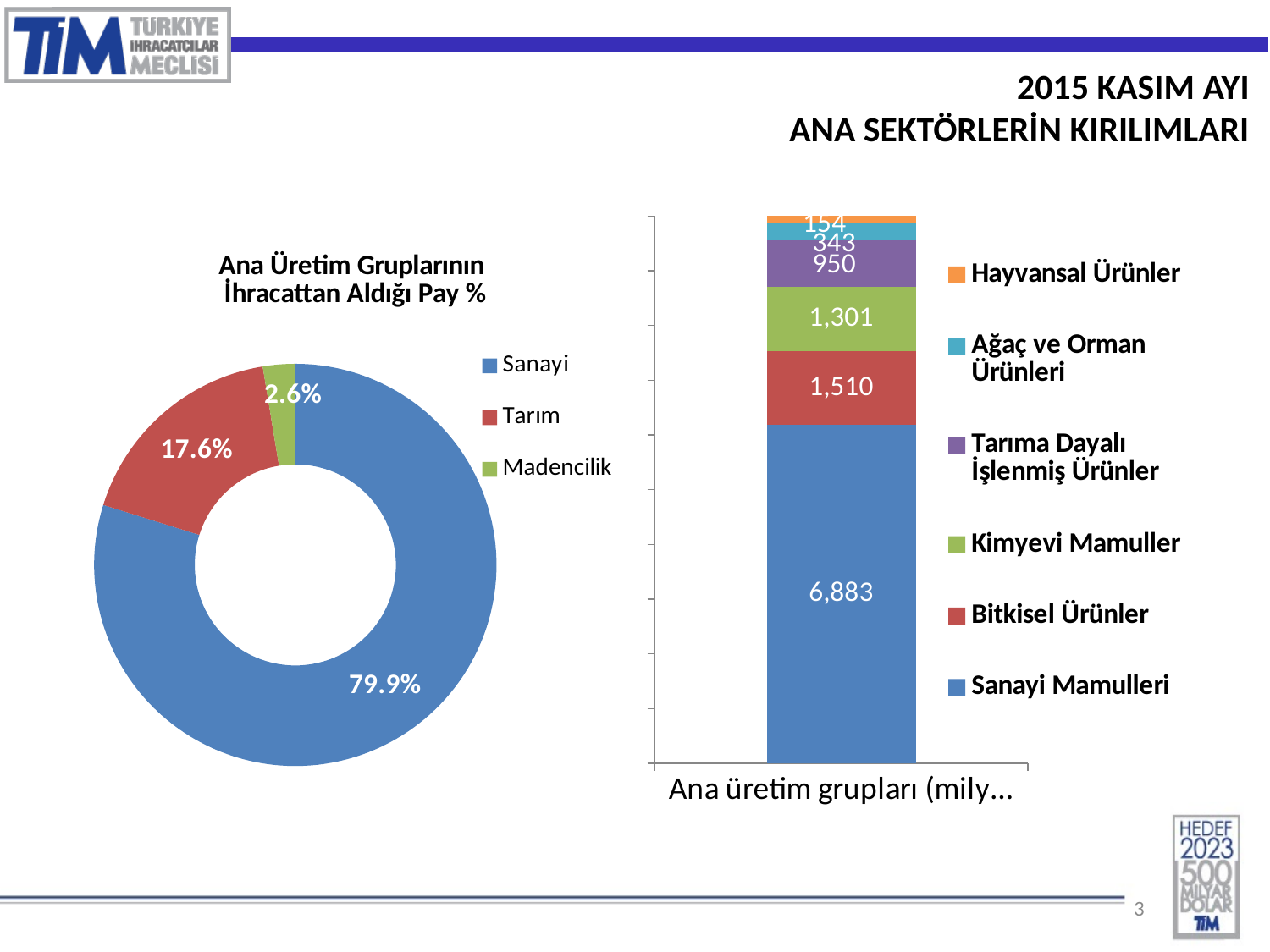
In the stacked bar chart on the right, what is the value for Sanayi Mamulleri? 6,883 In the doughnut chart on the left, which category has the smallest share? Madencilik What is the title of the chart on the left? Ana Üretim Gruplarının İhracattan Aldığı Pay % In the doughnut chart on the left, what share does Sanayi have? 79.9% In the stacked bar chart on the right, which series has the largest value? Sanayi Mamulleri In the stacked bar chart on the right, what is the total of the stacked bar? 11,141 In the stacked bar chart on the right, what is the value for Kimyevi Mamuller? 1,301 In the stacked bar chart on the right, how many series does the legend list? 6 In the doughnut chart on the left, how many categories does the legend list? 3 In the stacked bar chart on the right, what is the value for Hayvansal Ürünler? 154 In the doughnut chart on the left, what share does Tarım have? 17.6% In the stacked bar chart on the right, what is the difference between Bitkisel Ürünler and Kimyevi Mamuller? 209